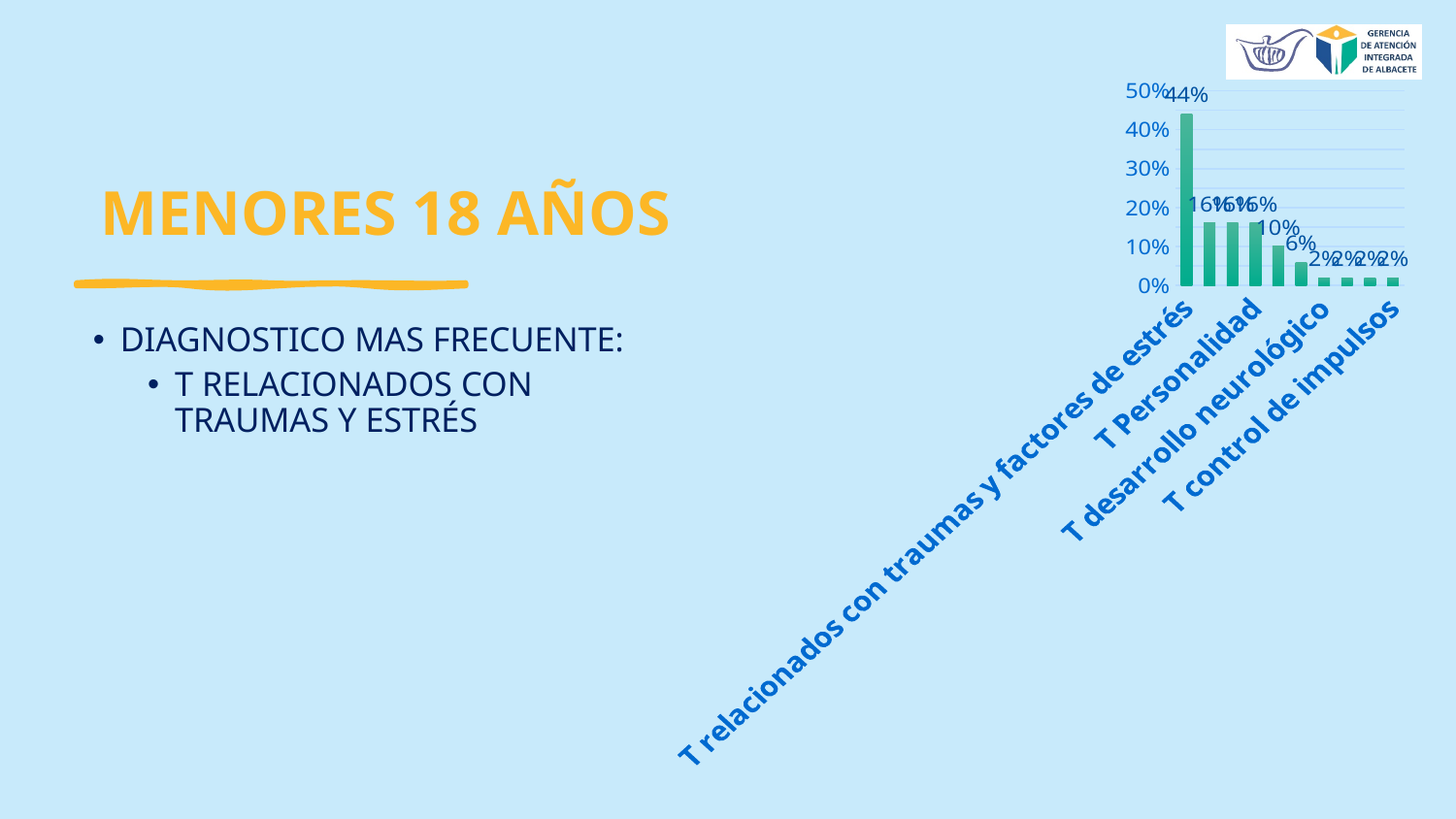
Which is larger, the value for 'T relacionados con traumas y factores de estrés' or for 'T control de impulsos'? T relacionados con traumas y factores de estrés Which category has the highest value in the chart? T relacionados con traumas y factores de estrés What is the lowest data label value shown in the chart? 2% Is the value for 'T relacionados con traumas y factores de estrés' greater or less than 40%? greater What kind of chart is shown on the slide? Bar chart What is the value for 'T control de impulsos'? 2% What colour are the bars in the chart? Green Do the values rise or fall from left to right along the x axis? Fall What is the difference between the highest value (44%) and the lowest value (2%) in the chart? 42% What is the value for 'T relacionados con traumas y factores de estrés'? 44% What is the maximum value shown on the vertical axis of the chart? 50% How many bars are plotted in the chart? 10